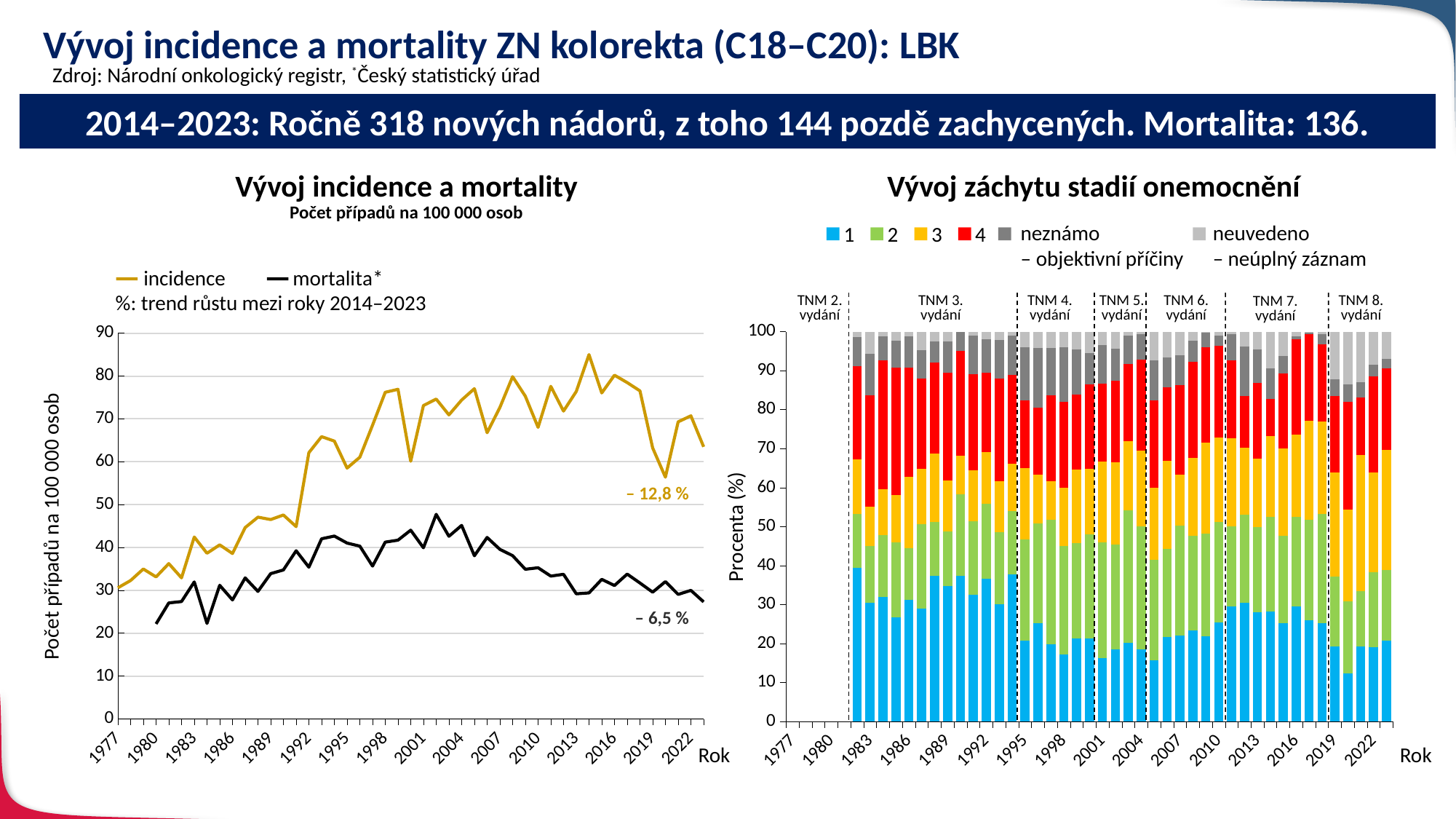
How many series does the legend of the right chart 'Vývoj záchytu stadií onemocnění' list? 6 On the left chart 'Vývoj incidence a mortality', what is the y-axis label? Počet případů na 100 000 osob What kind of chart is the right chart titled 'Vývoj záchytu stadií onemocnění'? stacked bar chart On the left chart 'Vývoj incidence a mortality', what growth trend between 2014 and 2023 is printed for incidence? – 12,8 % What kind of chart is the left chart titled 'Vývoj incidence a mortality'? line chart On the left chart 'Vývoj incidence a mortality', is the incidence value in 1977 greater or less than 40? less On the left chart 'Vývoj incidence a mortality', is the incidence value in 2015 greater or less than 80? less On the left chart 'Vývoj incidence a mortality', which series is higher in 2022, incidence or mortalita? incidence On the right chart 'Vývoj záchytu stadií onemocnění', what is the y-axis label? Procenta (%) How many series does the legend of the left chart 'Vývoj incidence a mortality' list? 2 On the left chart 'Vývoj incidence a mortality', what growth trend between 2014 and 2023 is printed for mortalita? – 6,5 % On the right chart 'Vývoj záchytu stadií onemocnění', which colour represents stage 4? red